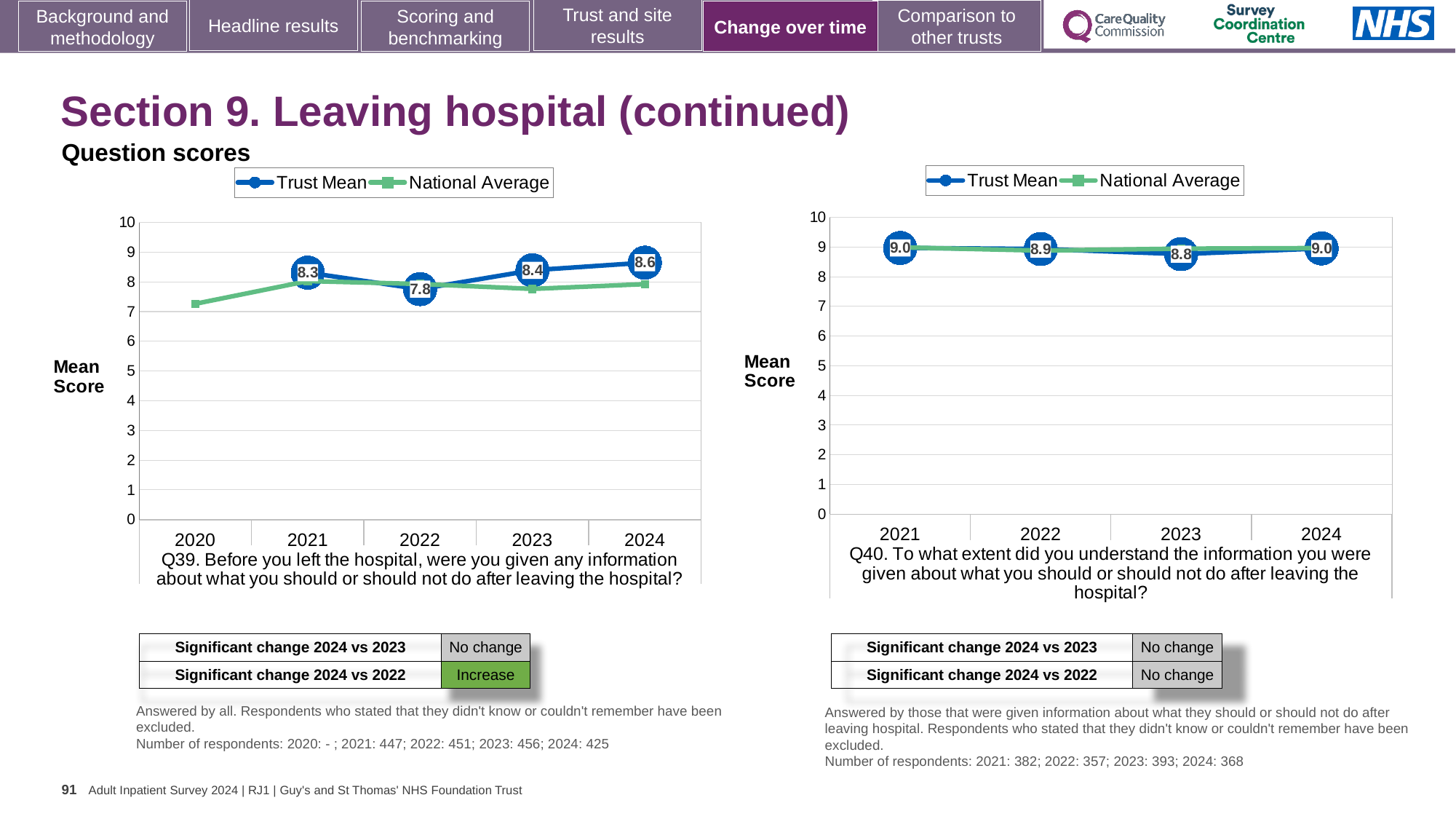
In the Q39 chart on the left, is the National Average value for 2020 greater or less than 8? less In the Q40 chart on the right, what is the difference between the Trust Mean scores for 2021 and 2023? 0.2 In the Q39 chart on the left, what is the difference between the Trust Mean scores for 2024 and 2022? 0.8 How many series does the legend of the Q39 chart on the left list? 2 In the Q39 chart on the left, which year has the highest Trust Mean score? 2024 In the Q39 chart on the left, what is the Trust Mean score for 2024? 8.6 How many years are shown on the x axis of the Q40 chart on the right? 4 In the Q39 chart on the left, which year has the larger Trust Mean score, 2021 or 2023? 2023 In the Q39 chart on the left, which year has the lowest Trust Mean score? 2022 In the Q39 chart on the left, what is the Trust Mean score for 2022? 7.8 In the Q40 chart on the right, what is the Trust Mean score for 2023? 8.8 In the Q40 chart on the right, which year has the lowest Trust Mean score? 2023